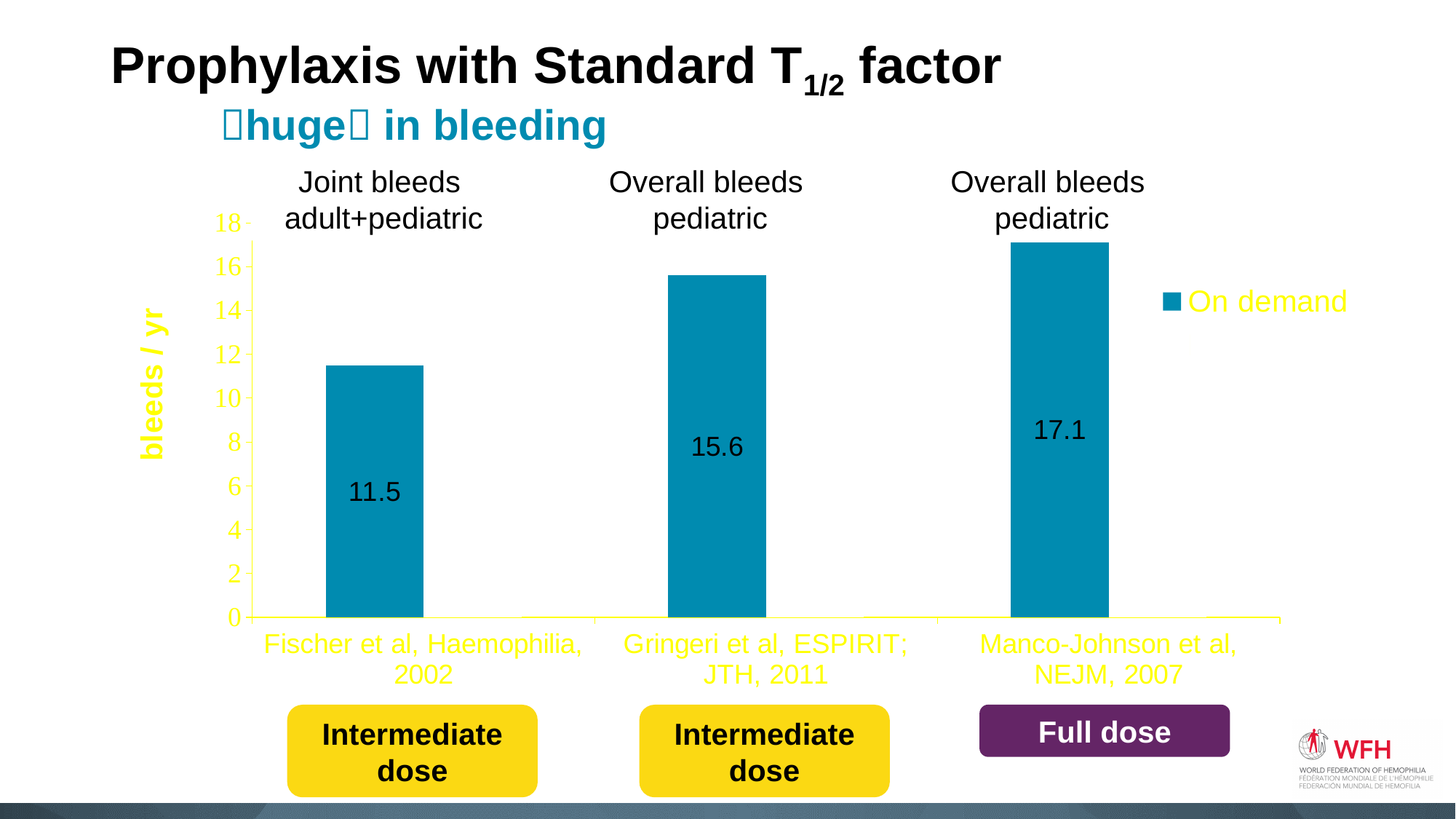
How many studies (categories) are shown on the x axis? 3 What kind of chart is shown on the slide? bar chart What is the difference between the On demand values for Gringeri et al, ESPIRIT; JTH, 2011 and Fischer et al, Haemophilia, 2002? 4.1 Which study has the highest On demand bleeds per year? Manco-Johnson et al, NEJM, 2007 Which study has the lowest On demand bleeds per year? Fischer et al, Haemophilia, 2002 What is the difference between the On demand values for Manco-Johnson et al, NEJM, 2007 and Fischer et al, Haemophilia, 2002? 5.6 What is the On demand value for Gringeri et al, ESPIRIT; JTH, 2011? 15.6 How many series does the legend list? 1 What is the On demand value for Fischer et al, Haemophilia, 2002? 11.5 Which is larger, the On demand value for Gringeri et al, ESPIRIT; JTH, 2011 or for Manco-Johnson et al, NEJM, 2007? Manco-Johnson et al, NEJM, 2007 Is the On demand value for Fischer et al, Haemophilia, 2002 greater or less than 12? less What is the On demand value for Manco-Johnson et al, NEJM, 2007? 17.1